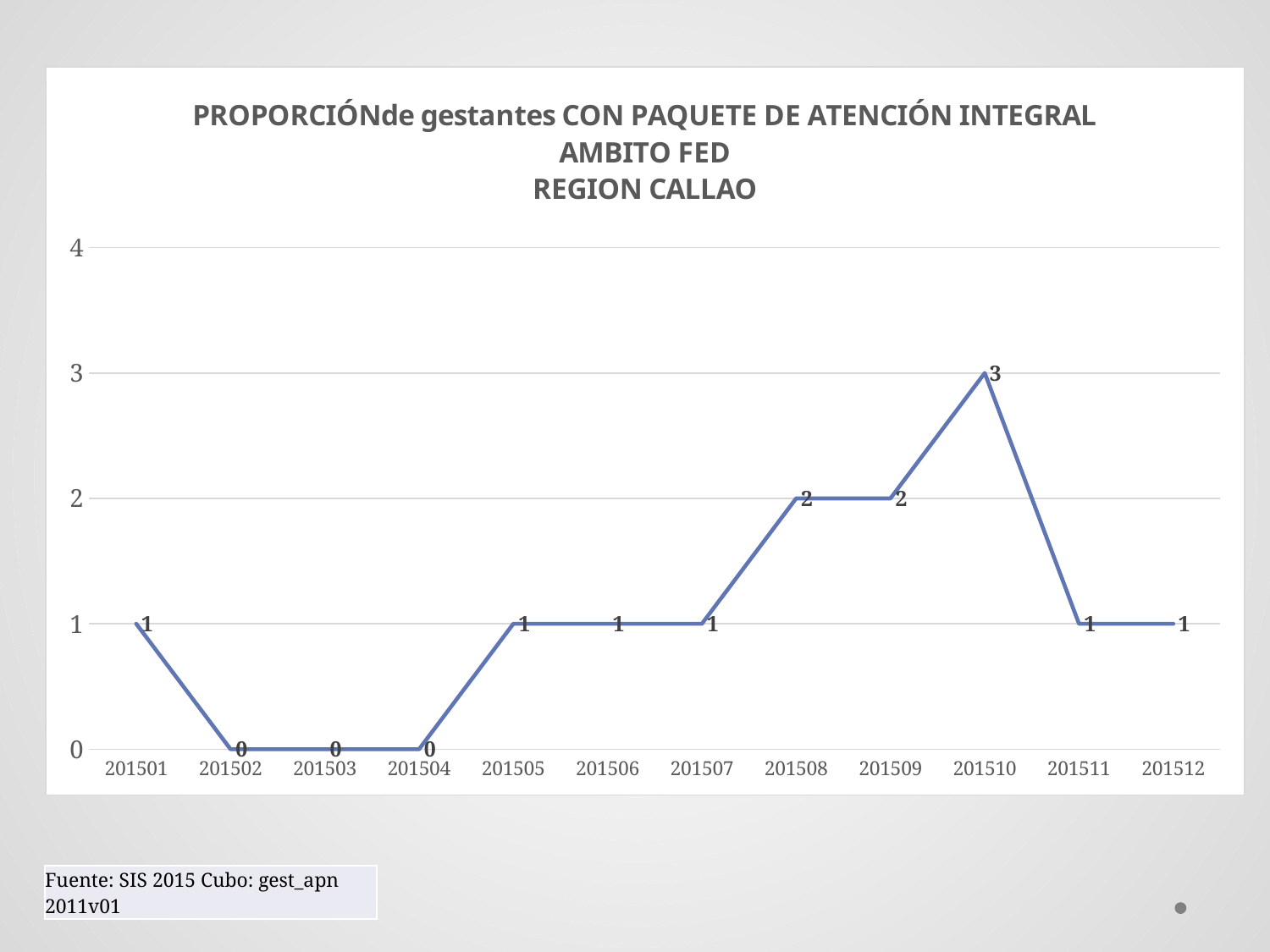
Which region is named in the chart title? REGION CALLAO What is the value for 201503? 0 What type of chart is shown on the slide? line chart How many periods have a value of 0? 3 Which is larger, the value for 201509 or the value for 201506? 201509 What is the value for 201512? 1 How many periods are plotted on the x axis? 12 Does the value rise or fall from 201510 to 201511? fall Which period has the highest value? 201510 What is the value for 201508? 2 What is the value for 201510? 3 What is the difference between the values for 201510 and 201511? 2